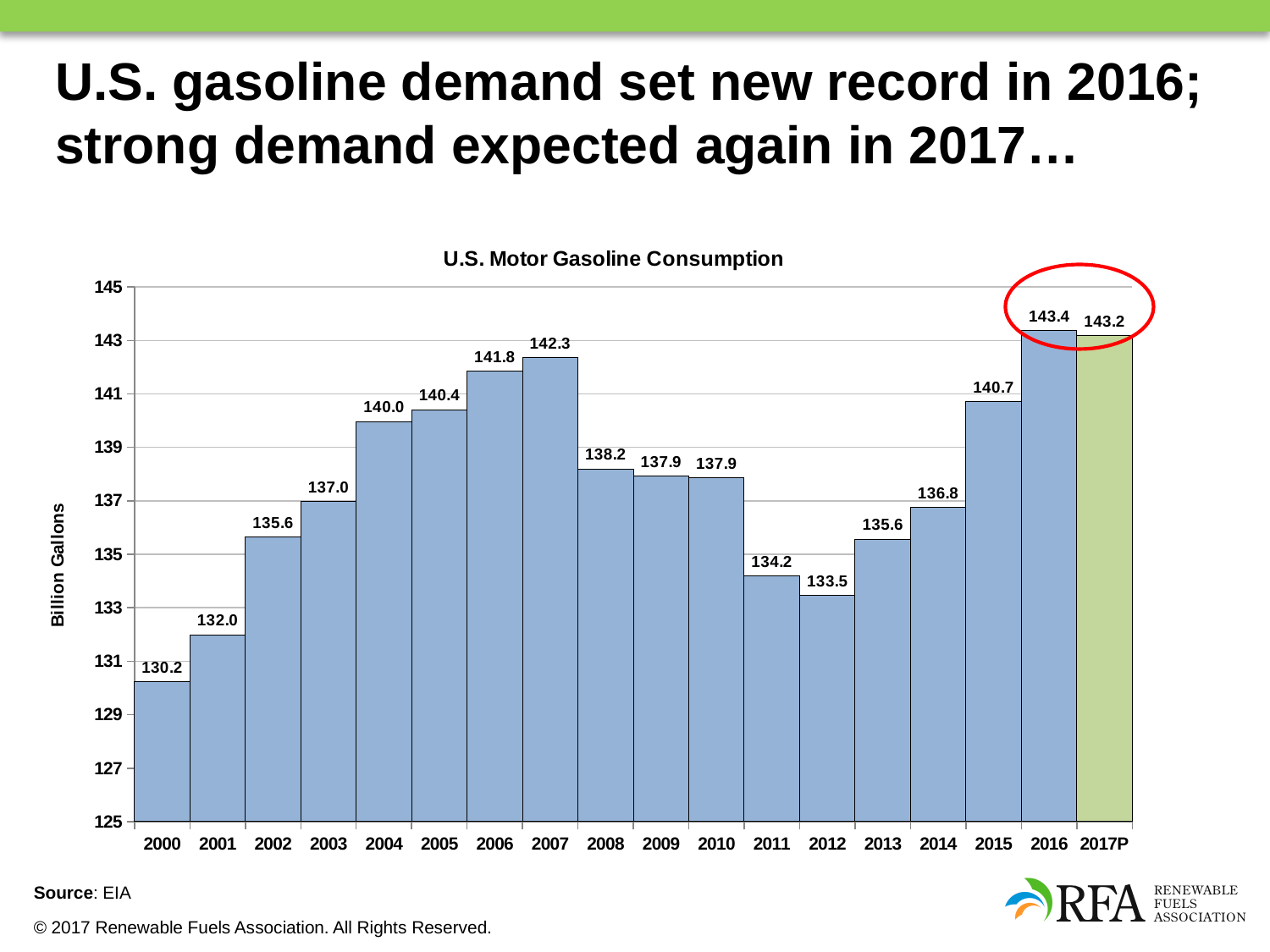
Do the values rise or fall from 2000 to 2007? rise Which is larger, the value for 2007 or the value for 2008? 2007 What is the value for 2016 in the U.S. Motor Gasoline Consumption chart? 143.4 What kind of chart is shown on the slide? bar chart What is the projected value for 2017P in the chart? 143.2 What is the value for 2012 in the U.S. Motor Gasoline Consumption chart? 133.5 How many years (bars) are shown in the chart? 18 What is the difference between the 2016 value and the 2015 value? 2.7 Is the value for 2011 greater or less than 135? less What is the label on the vertical axis of the chart? Billion Gallons Which year has the highest value in the chart? 2016 Which year has the lowest value in the chart? 2000